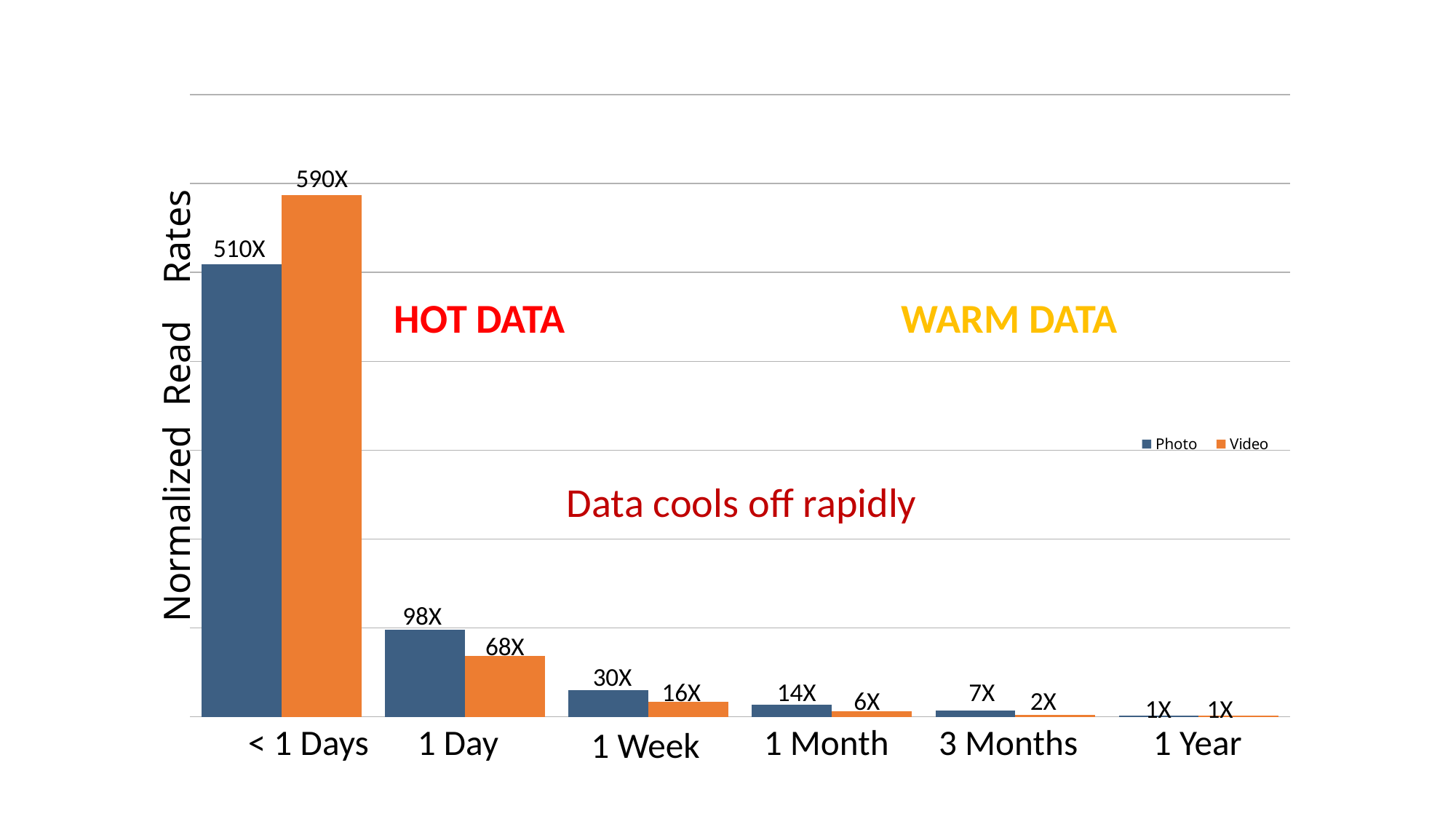
What is the Photo value for 3 Months? 7X What is the Video value for 1 Week? 16X How many categories are shown on the x axis? 6 What is the difference between the Photo and Video values for 1 Day? 30X What kind of chart is shown on the slide? Bar chart Which category has the highest Photo value? < 1 Days What is the Photo value for 1 Day? 98X What is the Video value for < 1 Days? 590X How many series does the legend list? 2 Which is larger for 1 Month, the Photo value or the Video value? Photo What is the difference between the Video and Photo values for < 1 Days? 80X Which category has the lowest Video value? 1 Year